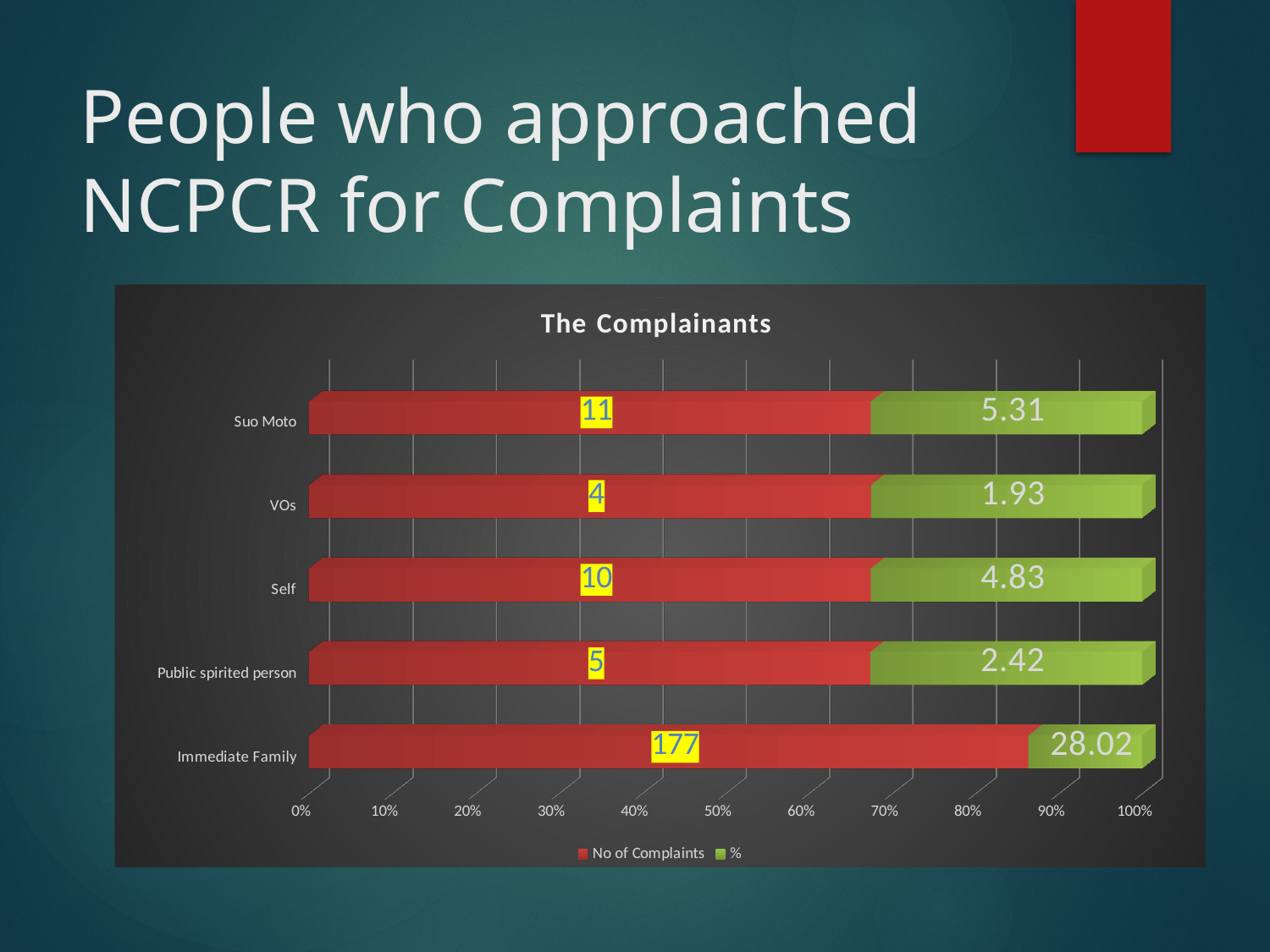
How many series does the legend list? 2 What is the % value for Suo Moto? 5.31 Which category has the lowest number of complaints? VOs What kind of chart is shown on the slide? Stacked bar chart What is the title of the chart? The Complainants What is the number of complaints for VOs? 4 What is the number of complaints for Immediate Family? 177 Which has a higher % value, Self or Public spirited person? Self How many categories are shown on the chart? 5 What is the % value for Public spirited person? 2.42 Which category has the highest number of complaints? Immediate Family What is the difference in number of complaints between Suo Moto and Self? 1